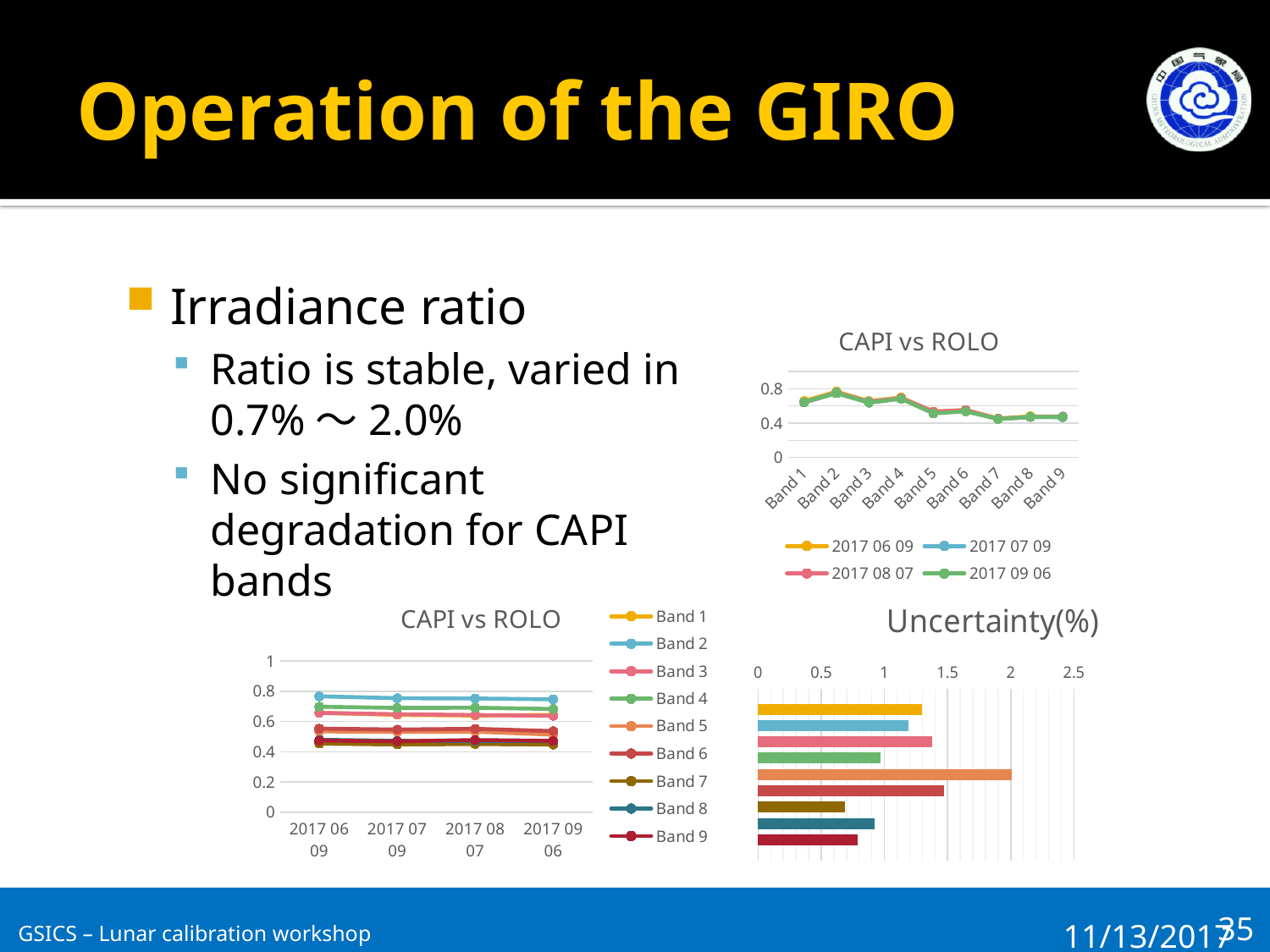
In the 'CAPI vs ROLO' chart at the bottom left, which is larger, the value for Band 2 or the value for Band 5? Band 2 In the 'CAPI vs ROLO' chart at the bottom left, how many series does the legend list? 9 In the 'CAPI vs ROLO' chart at the top right, is the value for Band 5 greater or less than 0.8? less How many bars are plotted in the 'Uncertainty(%)' chart? 9 In the 'Uncertainty(%)' chart, is the longest bar (the fifth from the top) greater or less than 1.5? greater In the 'CAPI vs ROLO' chart at the top right, how many series does the legend list? 4 What kind of chart is the 'Uncertainty(%)' chart at the bottom right of the slide? bar chart In the 'CAPI vs ROLO' chart at the bottom left, which band has the highest ratio? Band 2 What kind of chart is the 'CAPI vs ROLO' chart at the bottom left of the slide? line chart In the 'CAPI vs ROLO' chart at the bottom left, is the value for Band 9 greater or less than 0.6? less In the 'CAPI vs ROLO' chart at the bottom left, how many dates are shown on the x axis? 4 In the 'CAPI vs ROLO' chart at the top right, how many bands are shown on the x axis? 9